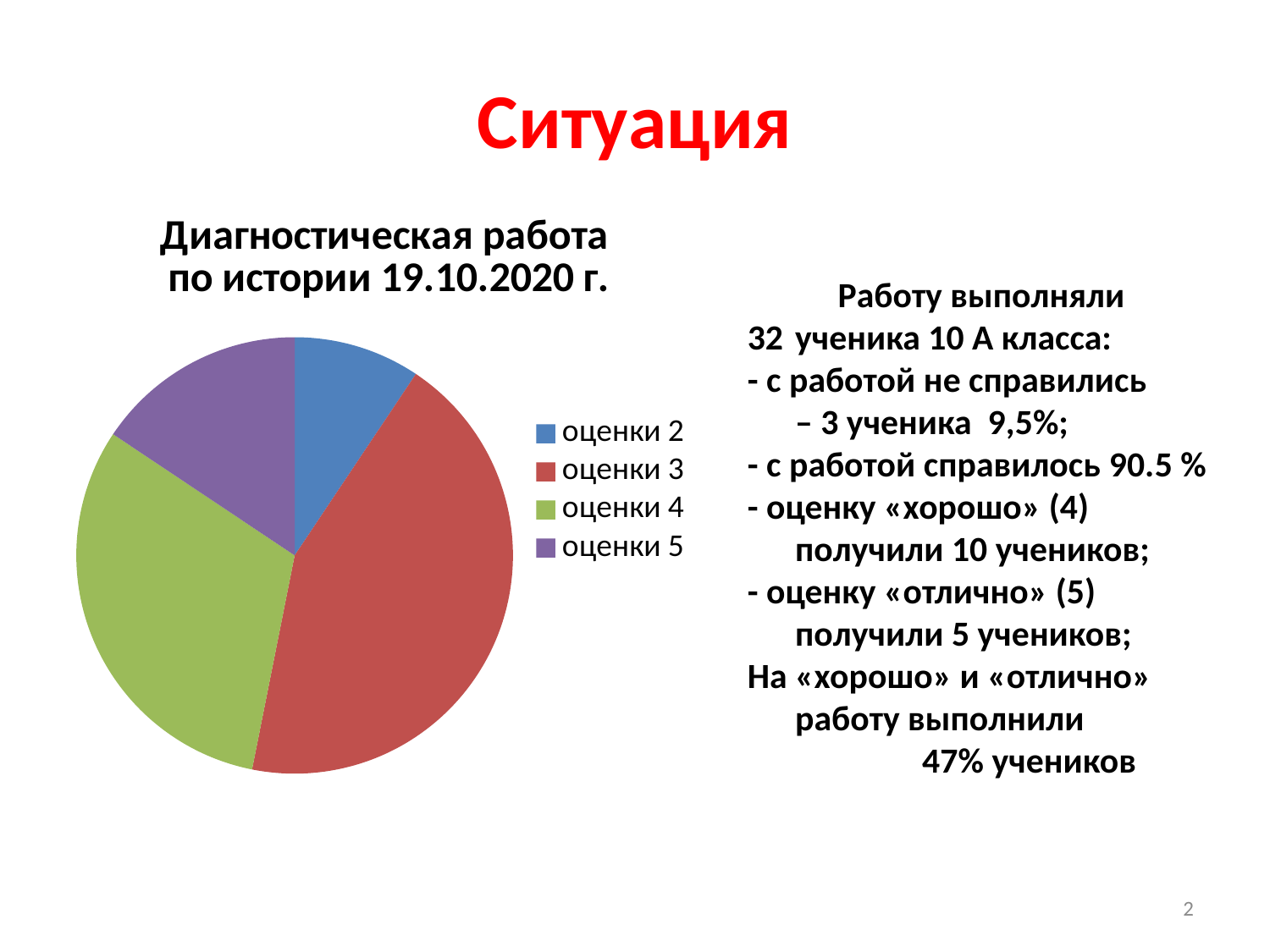
What kind of chart is shown on the slide? pie chart Which slice is larger, оценки 5 or оценки 2? оценки 5 Which category has the largest slice of the pie? оценки 3 What colour is the slice for оценки 4 in the pie chart? green Which slice is larger, оценки 4 or оценки 5? оценки 4 What is the title of the chart? Диагностическая работа по истории 19.10.2020 г. How many slices does the pie chart have? 4 How many entries does the chart legend list? 4 Which slice is larger, оценки 3 or оценки 4? оценки 3 Which category has the smallest slice of the pie? оценки 2